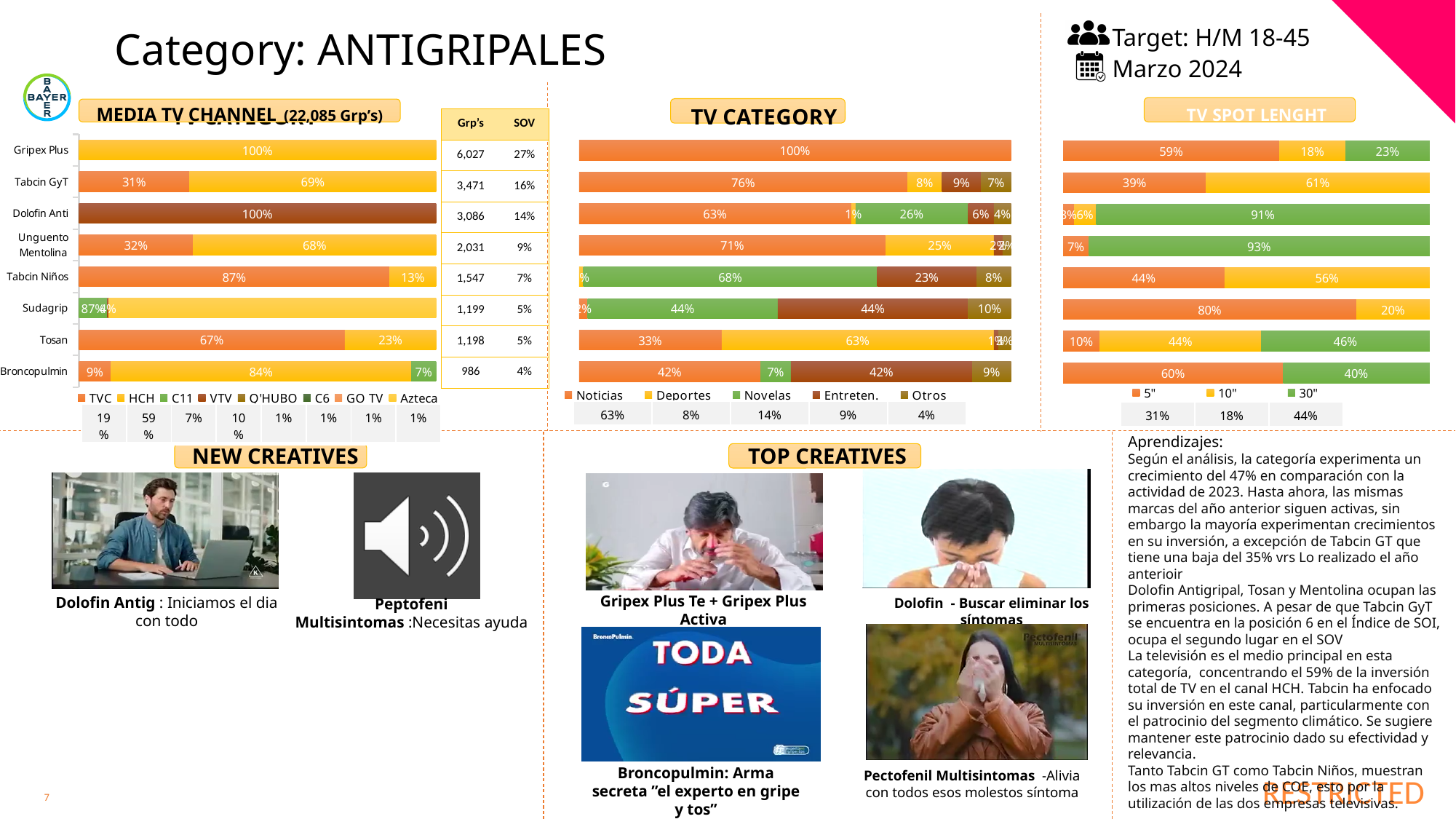
On the TV CATEGORY chart, what is the overall share for Noticias shown under the legend? 63% How many brands (categories) are shown on the MEDIA TV CHANNEL chart? 8 How many series does the legend of the TV SPOT LENGHT chart list? 3 On the MEDIA TV CHANNEL chart, what is the HCH share for Tabcin GyT? 69% On the MEDIA TV CHANNEL chart, what is the difference between the TVC share and the HCH share for Tabcin Niños? 74 percentage points On the MEDIA TV CHANNEL chart, which is larger for Tosan: the TVC share or the HCH share? TVC (67%) On the TV SPOT LENGHT chart, what is the 5" share in the top bar? 59% What kind of chart is the MEDIA TV CHANNEL chart? Stacked bar chart How many series does the legend of the TV CATEGORY chart list? 5 On the MEDIA TV CHANNEL chart, what is the HCH share for Broncopulmin? 84% How many series does the legend of the MEDIA TV CHANNEL chart list? 8 On the MEDIA TV CHANNEL chart, which channel has the largest overall share according to the totals under the legend? HCH (59%)